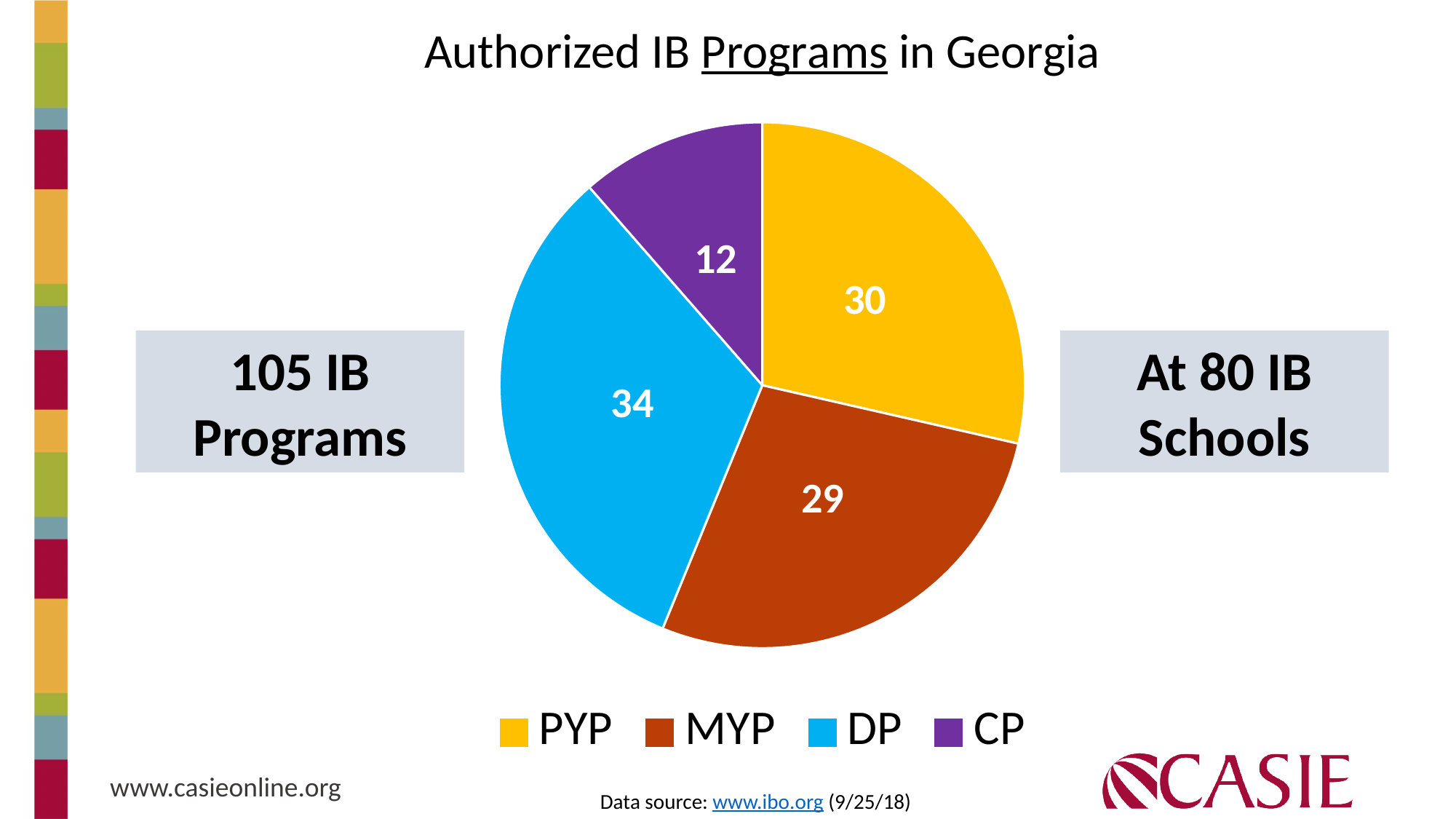
How many entries does the legend list? 4 Which program has the largest slice of the pie? DP What is the difference between the values for DP and CP? 22 Which program has the smallest slice of the pie? CP What is the value for MYP? 29 Which is larger, the value for PYP or the value for MYP? PYP What is the title of the chart? Authorized IB Programs in Georgia What is the value for CP? 12 What is the total of all four slices in the pie chart? 105 What is the value for DP? 34 What type of chart is shown on the slide? Pie chart How many slices does the pie chart have? 4